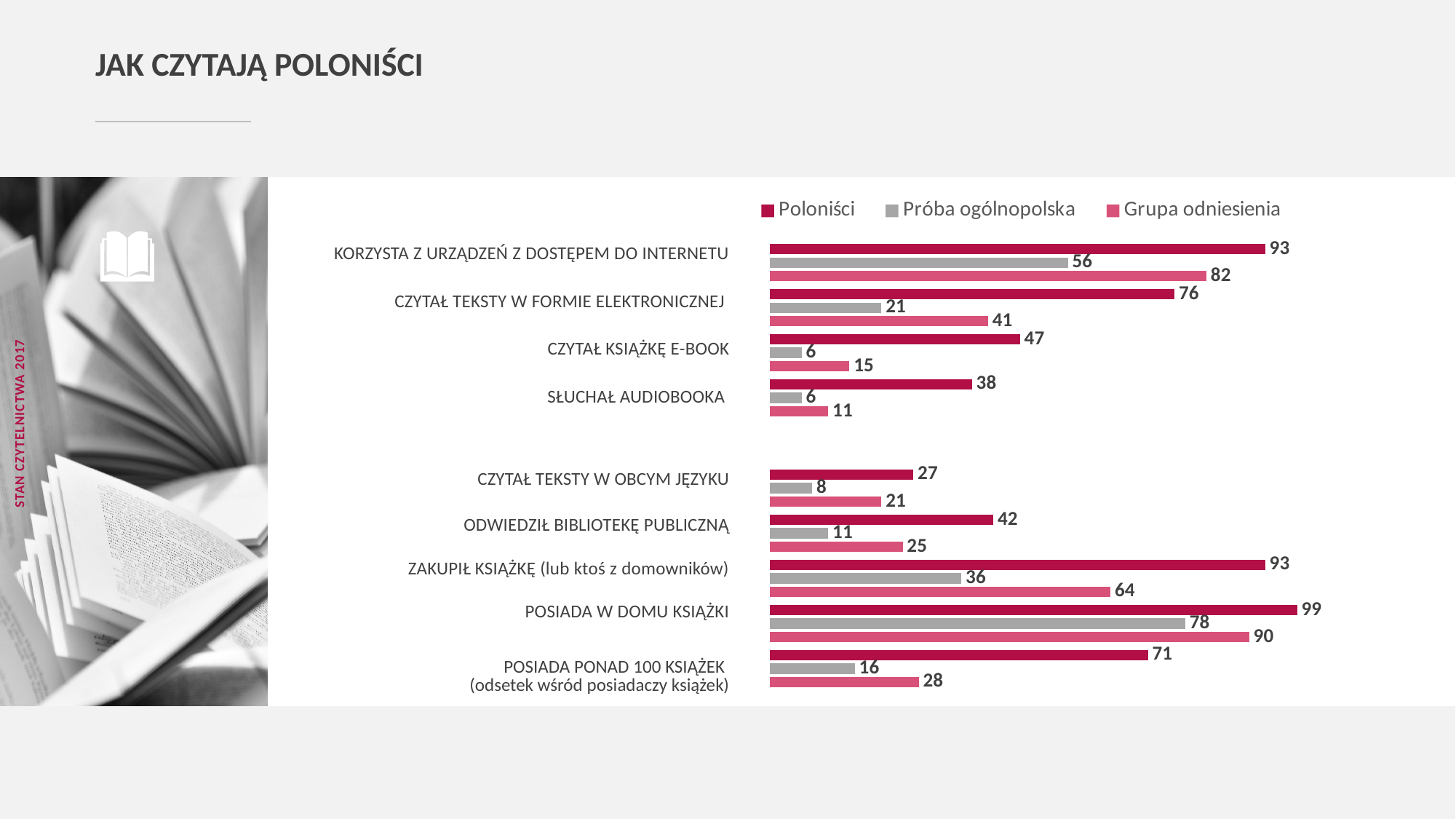
What kind of chart is shown on the slide? bar chart Which is larger: the Grupa odniesienia value for 'ODWIEDZIŁ BIBLIOTEKĘ PUBLICZNĄ' or the Grupa odniesienia value for 'CZYTAŁ TEKSTY W OBCYM JĘZYKU'? ODWIEDZIŁ BIBLIOTEKĘ PUBLICZNĄ How many categories are shown on the chart? 9 Which category has the lowest value for Grupa odniesienia? SŁUCHAŁ AUDIOBOOKA What is the value for Grupa odniesienia in the category 'ZAKUPIŁ KSIĄŻKĘ (lub ktoś z domowników)'? 64 What is the title of the slide? JAK CZYTAJĄ POLONIŚCI What is the value for Poloniści in the category 'CZYTAŁ KSIĄŻKĘ E-BOOK'? 47 Which series is shown in grey in the legend? Próba ogólnopolska Which category has the highest value for Poloniści? POSIADA W DOMU KSIĄŻKI What is the value for Próba ogólnopolska in the category 'KORZYSTA Z URZĄDZEŃ Z DOSTĘPEM DO INTERNETU'? 56 What is the difference between the Poloniści and Próba ogólnopolska values for 'CZYTAŁ TEKSTY W FORMIE ELEKTRONICZNEJ'? 55 How many series does the legend list? 3